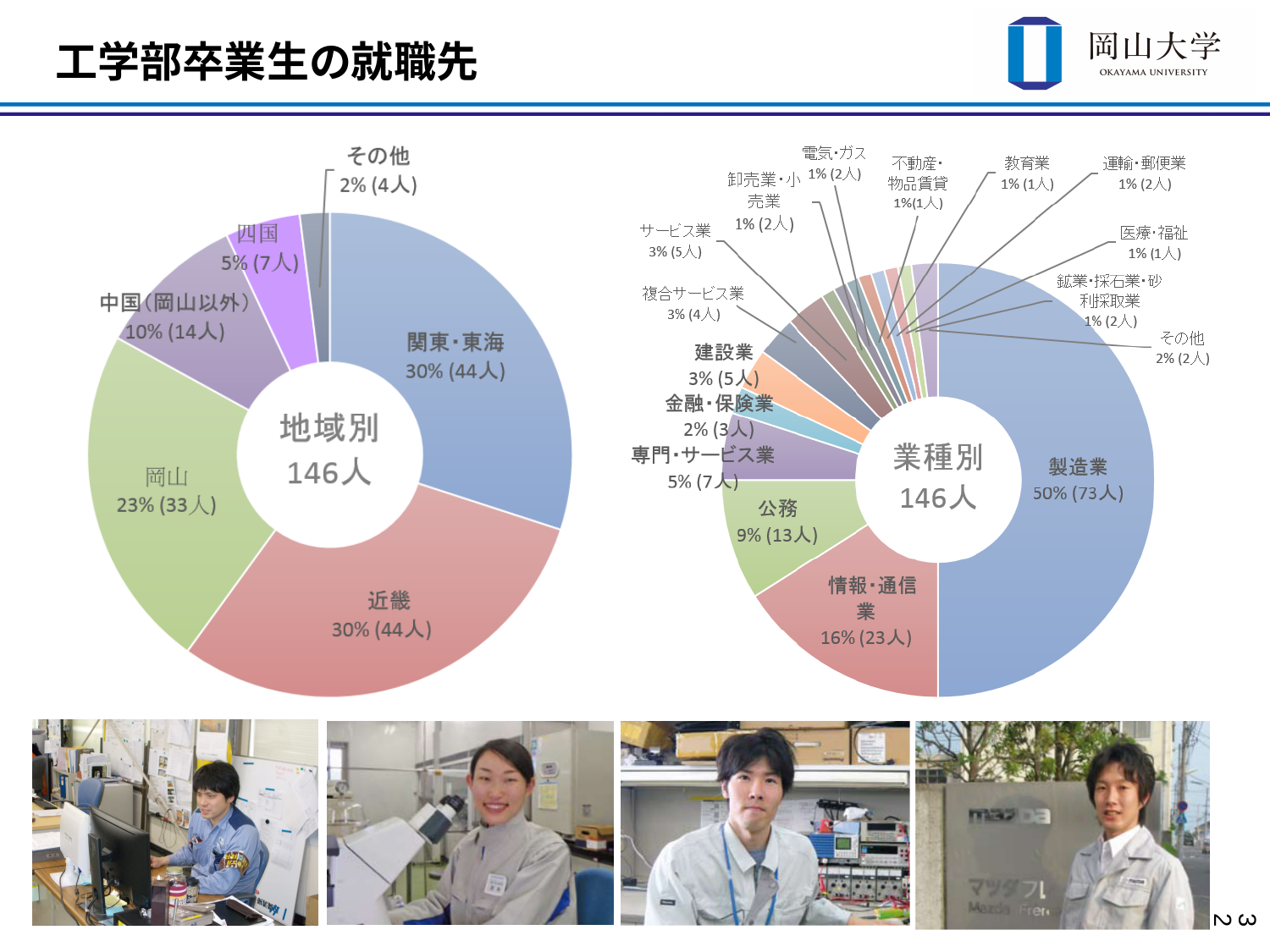
In the 業種別 chart, which industry has the largest slice? 製造業 In the 業種別 chart, how many more people are in 製造業 than in 情報・通信業? 50人 In the 業種別 chart, what is the value shown for 製造業? 50% (73人) In the 業種別 chart, what share of the total does 情報・通信業 represent? 16% What total number of people is shown in the centre of the 業種別 chart? 146人 In the 地域別 chart, how many more people are in 岡山 than in 中国(岡山以外)? 19人 What kind of chart is the 地域別 chart? Pie (donut) chart In the 地域別 chart, how many people are in the 四国 slice? 7人 In the 地域別 chart, which region has the smallest slice? その他 In the 地域別 chart, how many categories are shown? 6 In the 地域別 chart, what is the value shown for 岡山? 23% (33人) In the 業種別 chart, which is larger, 公務 or 専門・サービス業? 公務